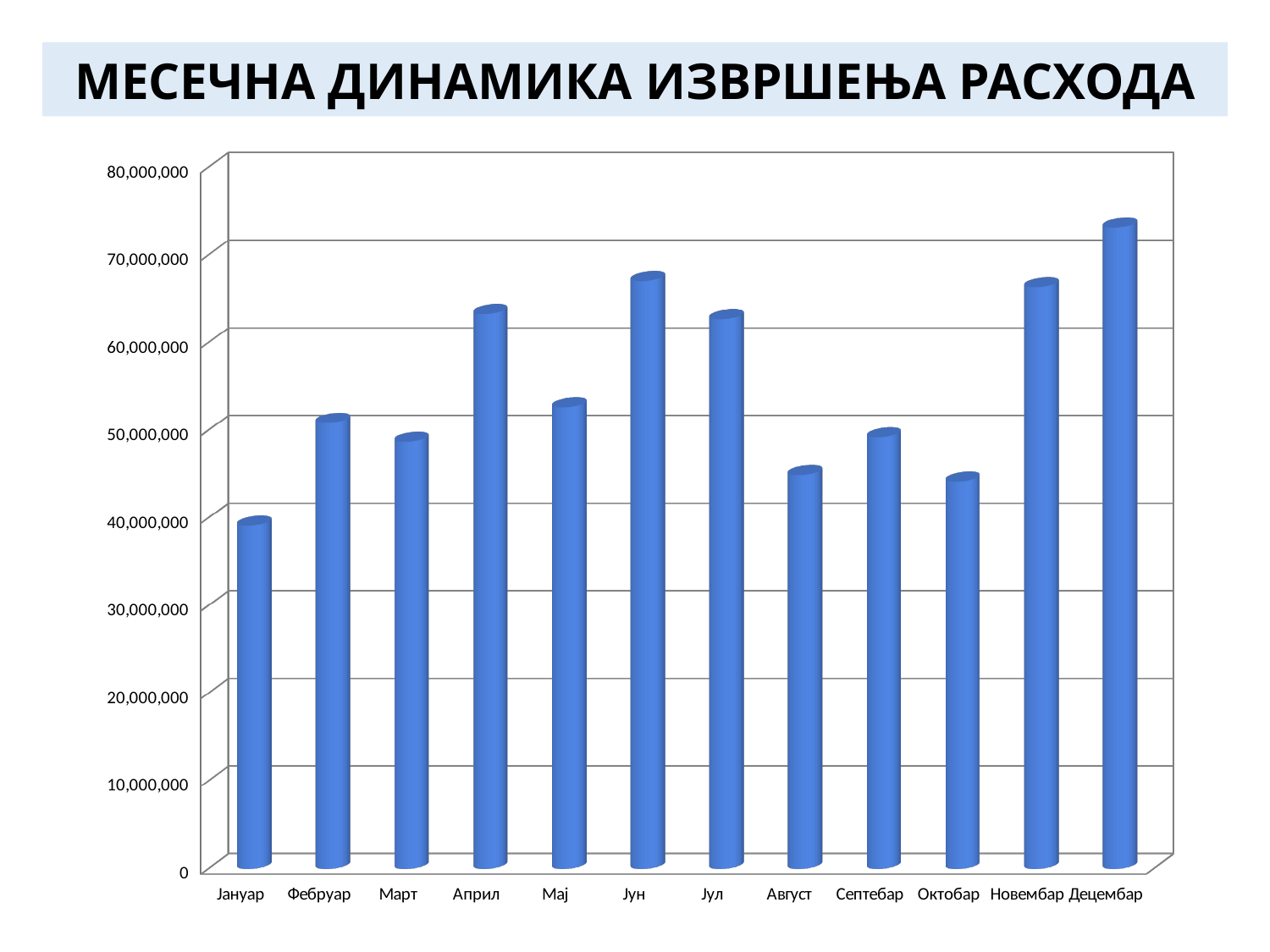
Is the value for Децембар greater or less than 70,000,000? greater Which month has the highest value? Децембар Is the value for Август greater or less than 50,000,000? less What kind of chart is shown on the slide? bar chart Is the value for Јун greater or less than 60,000,000? greater Which is larger, the value for Јун or the value for Мај? Јун What is the title of the chart? МЕСЕЧНА ДИНАМИКА ИЗВРШЕЊА РАСХОДА Which is larger, the value for Децембар or the value for Новембар? Децембар Which month has the lowest value? Јануар How many months (categories) are shown on the x axis? 12